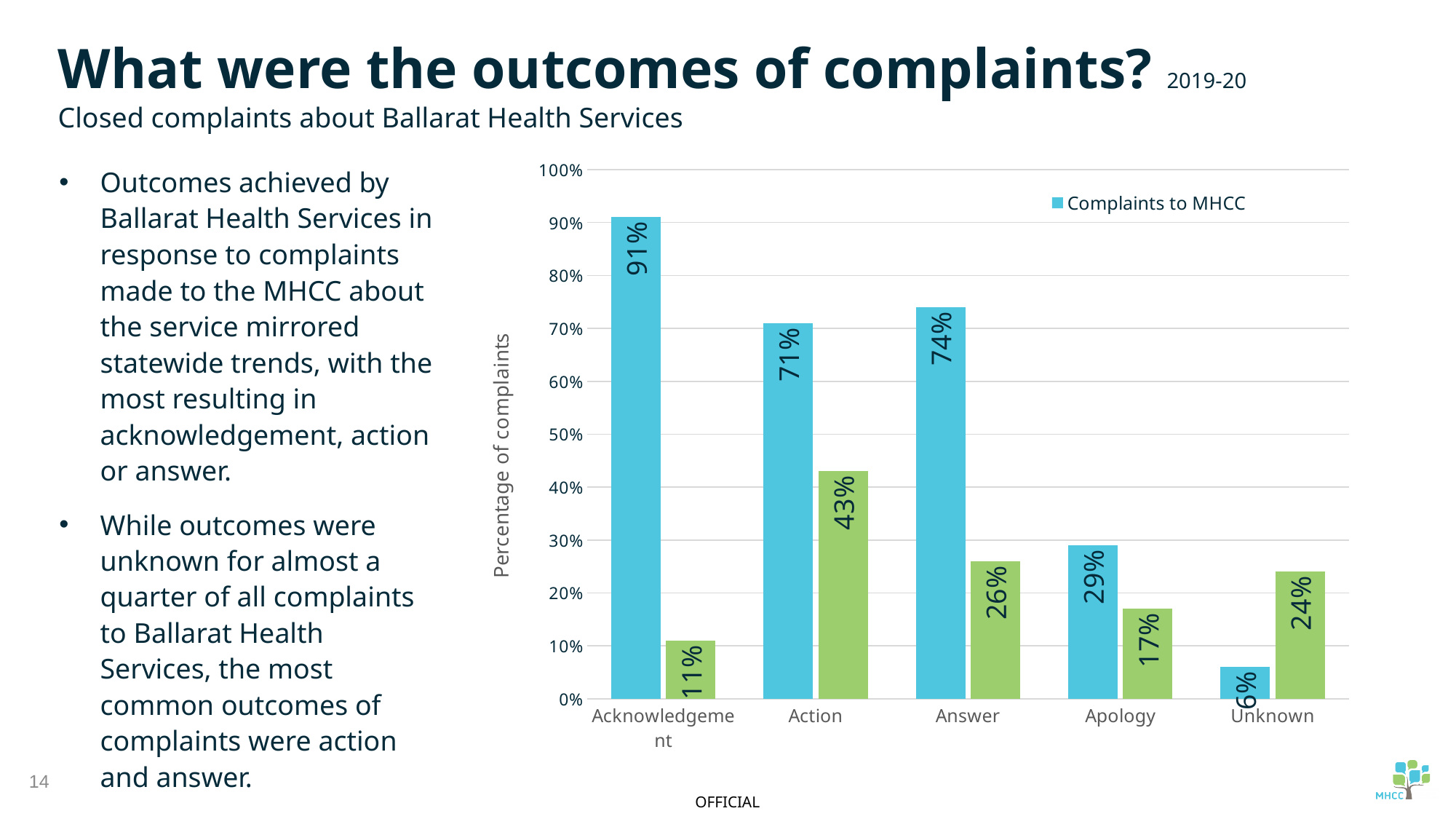
What is the value of the Complaints to MHCC bar for Apology? 29% What is the value of the green bar for Unknown? 24% For Unknown, which is larger: the Complaints to MHCC bar or the green bar? The green bar How many categories are shown on the x axis? 5 What is the difference between the Complaints to MHCC value for Answer and the green bar value for Answer? 48% What kind of chart is shown on the slide? Bar chart What is the value of the green bar for Action? 43% Which category has the lowest Complaints to MHCC value? Unknown What is the value of the Complaints to MHCC bar for Acknowledgement? 91% Which category has the lowest green bar value? Acknowledgement How many series does the legend list? 1 Which category has the highest Complaints to MHCC value? Acknowledgement